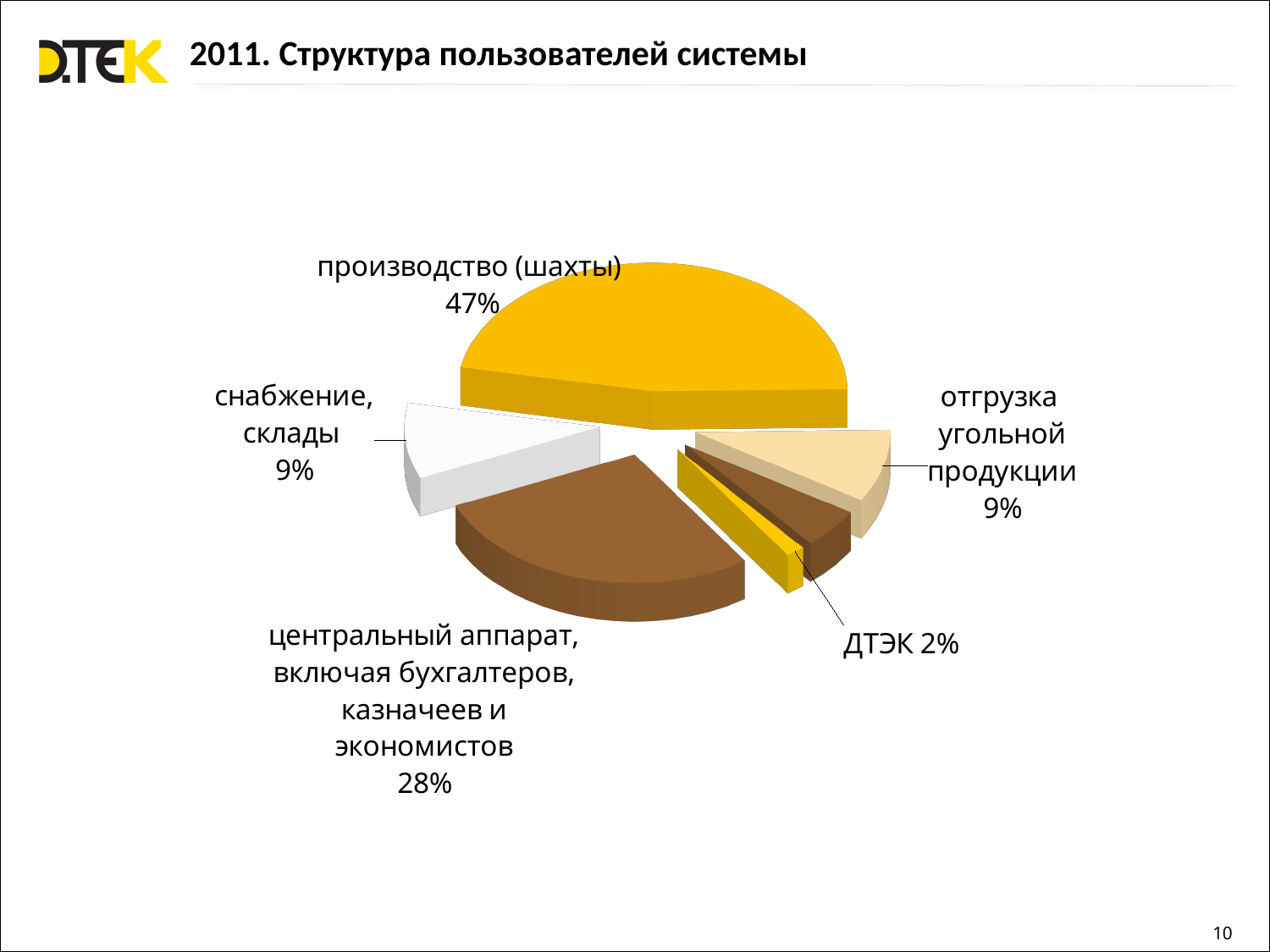
What share of the pie does ДТЭК have? 2% Which category has the largest share of the pie? производство (шахты) What is the difference in percentage points between производство (шахты) and центральный аппарат, включая бухгалтеров, казначеев и экономистов? 19 percentage points What share of the pie does производство (шахты) have? 47% What is the title of the slide? 2011. Структура пользователей системы Which category has the smallest share of the pie? ДТЭК What share of the pie does снабжение, склады have? 9% Which is larger: the share for снабжение, склады or the share for ДТЭК? снабжение, склады What kind of chart is shown on the slide? Pie chart How many slices does the pie chart have? 6